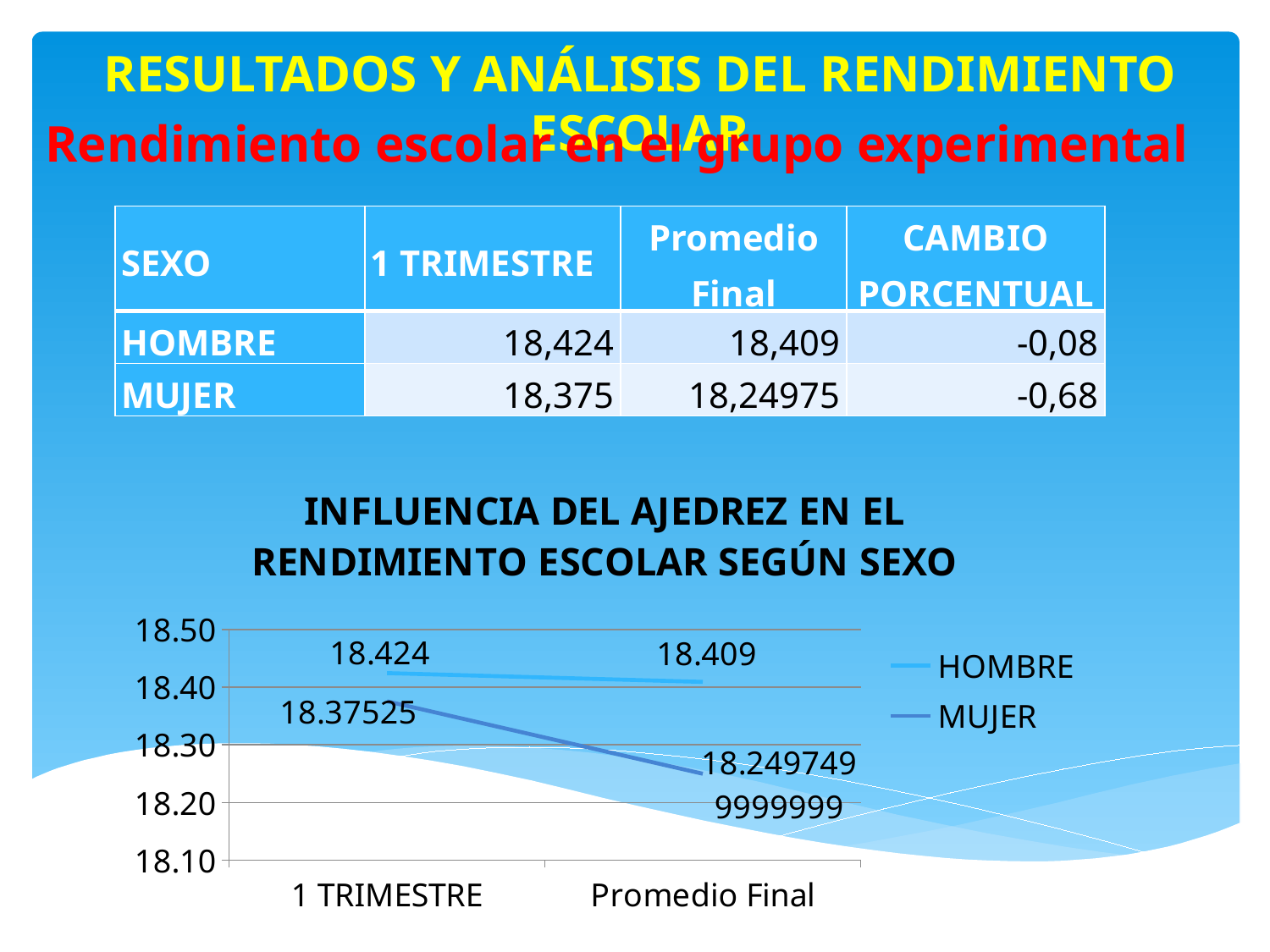
Which series are listed in the chart legend? HOMBRE and MUJER What is the title of the chart? INFLUENCIA DEL AJEDREZ EN EL RENDIMIENTO ESCOLAR SEGÚN SEXO What is the value for HOMBRE at 1 TRIMESTRE in the chart? 18.424 What kind of chart is shown on the slide? line chart What is the value for MUJER at 1 TRIMESTRE in the chart? 18.37525 How many series does the chart legend list? 2 How many categories are shown on the x axis of the chart? 2 Is the value for MUJER at Promedio Final greater or less than 18.30? less Does the HOMBRE line rise or fall from 1 TRIMESTRE to Promedio Final? fall Which series has the higher value at Promedio Final, HOMBRE or MUJER? HOMBRE Does the MUJER line rise or fall from 1 TRIMESTRE to Promedio Final? fall What is the value for HOMBRE at Promedio Final in the chart? 18.409